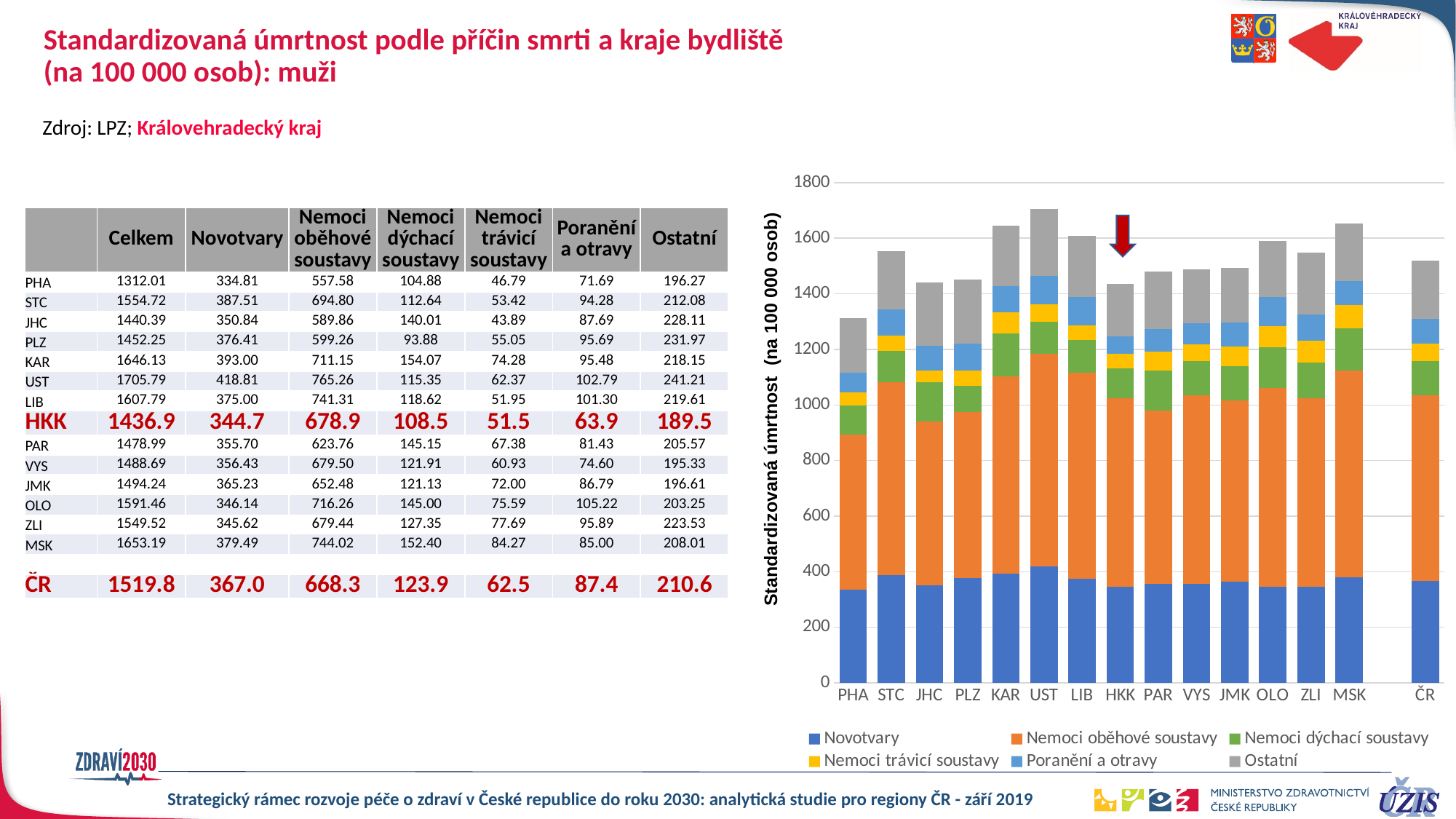
Is the total value of the HKK bar greater or less than 1400? greater Which has the larger total bar, STC or JHC? STC What kind of chart is shown on the slide? bar chart What colour represents the Ostatní series in the chart? grey Which region has the tallest stacked bar in the chart? UST How many series does the chart legend list? 6 How many regions (categories) are shown along the x axis of the chart? 15 Which region has the shortest stacked bar in the chart? PHA Is the total value of the PHA bar greater or less than 1400? less What is the difference between the Celkem value for ČR and the Celkem value for HKK? 82.9 What is the Novotvary value for ČR? 367.0 What is the Celkem (total) value for HKK? 1436.9